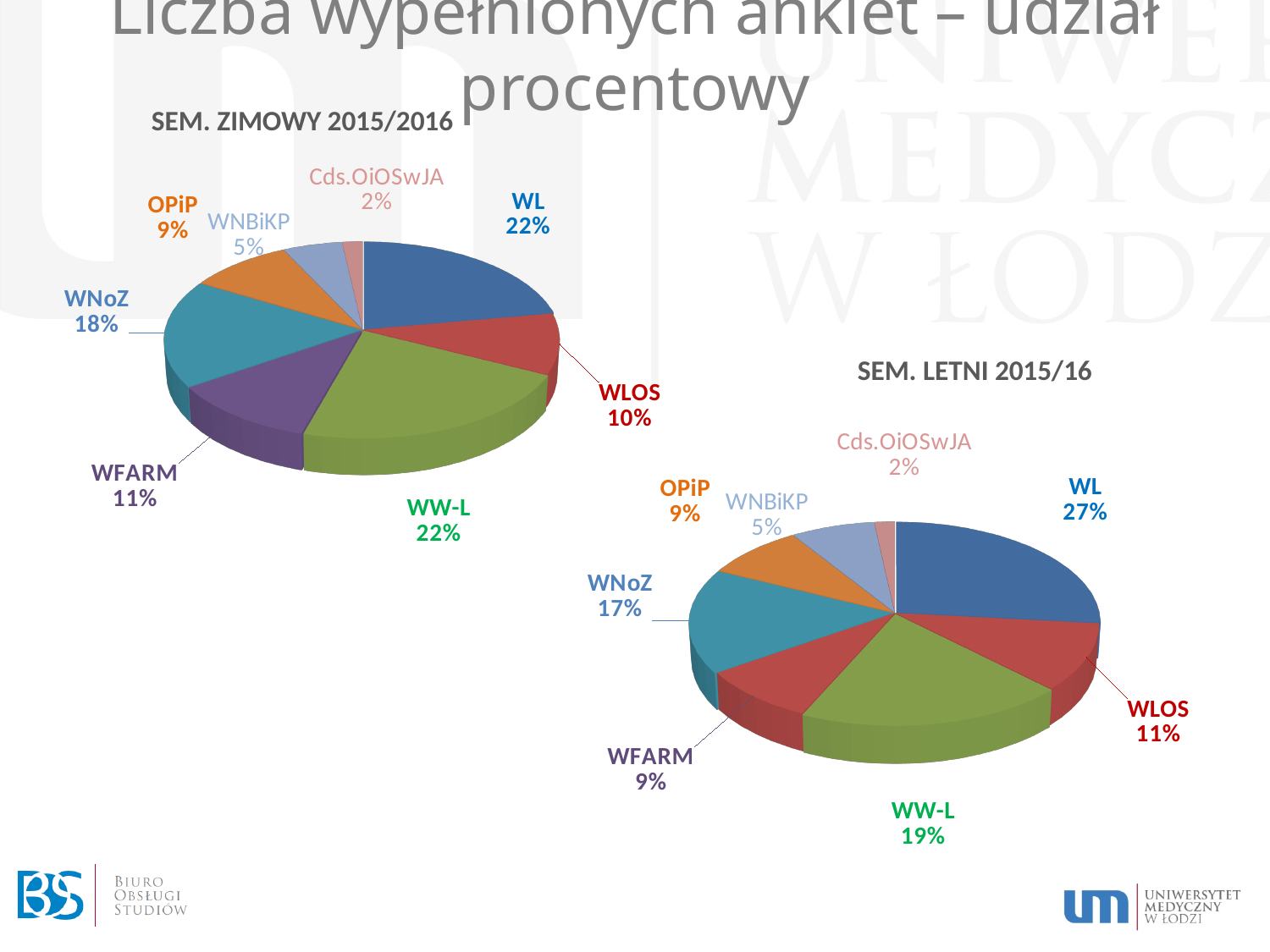
In the SEM. LETNI 2015/16 chart, which category has the largest share? WL In the SEM. LETNI 2015/16 chart, which category has the smallest share? Cds.OiOSwJA What is the title of the chart on the left side of the slide? SEM. ZIMOWY 2015/2016 How many categories are shown in the SEM. ZIMOWY 2015/2016 pie chart? 8 In the SEM. ZIMOWY 2015/2016 chart, which is larger, the share of WNoZ or the share of WFARM? WNoZ In the SEM. ZIMOWY 2015/2016 chart, which category has the smallest share? Cds.OiOSwJA In the SEM. LETNI 2015/16 chart, what share does WW-L have? 19% In the SEM. LETNI 2015/16 chart, what share does WL have? 27% In the SEM. LETNI 2015/16 chart, what is the difference in percentage points between WL and WW-L? 8 In the SEM. ZIMOWY 2015/2016 chart, what share does WLOS have? 10% What type of chart is used for SEM. LETNI 2015/16? Pie chart In the SEM. ZIMOWY 2015/2016 chart, what share does WNoZ have? 18%